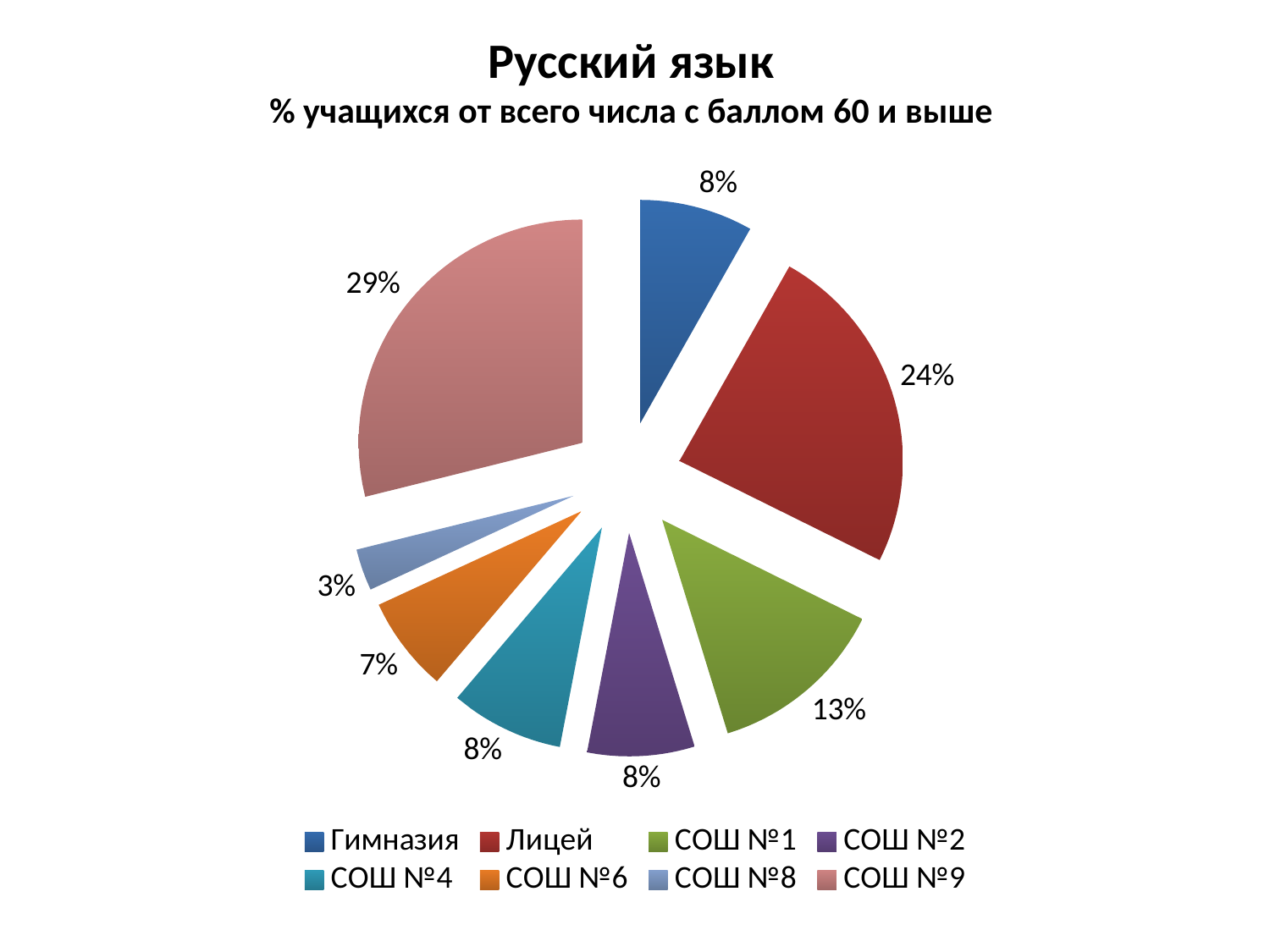
What is the value for СОШ №9? 29% What is the title of the chart? Русский язык Which category has the largest share of the pie? СОШ №9 What is the value for Лицей? 24% What is the value for СОШ №6? 7% Which category has the smallest share of the pie? СОШ №8 How many categories does the legend list? 8 Which is larger, the value for Лицей or the value for СОШ №1? Лицей What is the value for СОШ №1? 13% What is the value for СОШ №8? 3% What is the difference between the values for СОШ №9 and Лицей? 5% What kind of chart is shown on the slide? pie chart